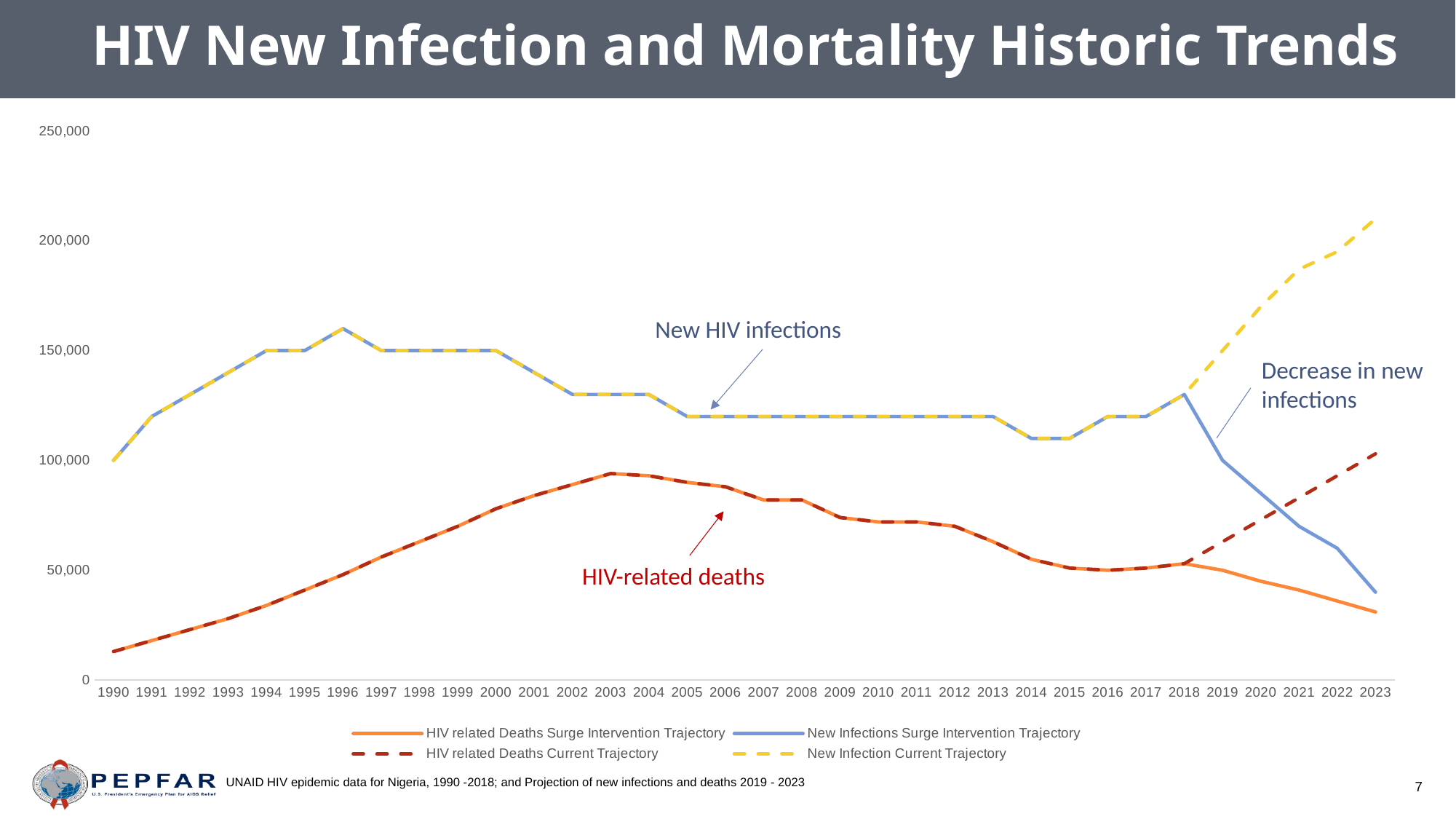
Is the value of the New Infection Current Trajectory in 2023 greater or less than 200,000? greater In 2023, which is higher: the New Infection Current Trajectory or the New Infections Surge Intervention Trajectory? New Infection Current Trajectory Is the value of the New Infections Surge Intervention Trajectory in 2023 greater or less than 50,000? less How many years are shown along the x axis? 34 Is the value of the HIV related Deaths Surge Intervention Trajectory in 2023 greater or less than 50,000? less What kind of chart is shown on the slide? line chart How many series does the legend list? 4 Does the New Infection Current Trajectory rise or fall between 2018 and 2023? rise In which year does the HIV related Deaths Surge Intervention Trajectory reach its highest value? 2003 In which year does the New Infections Surge Intervention Trajectory reach its highest value? 1996 Does the New Infections Surge Intervention Trajectory rise or fall between 2018 and 2023? fall